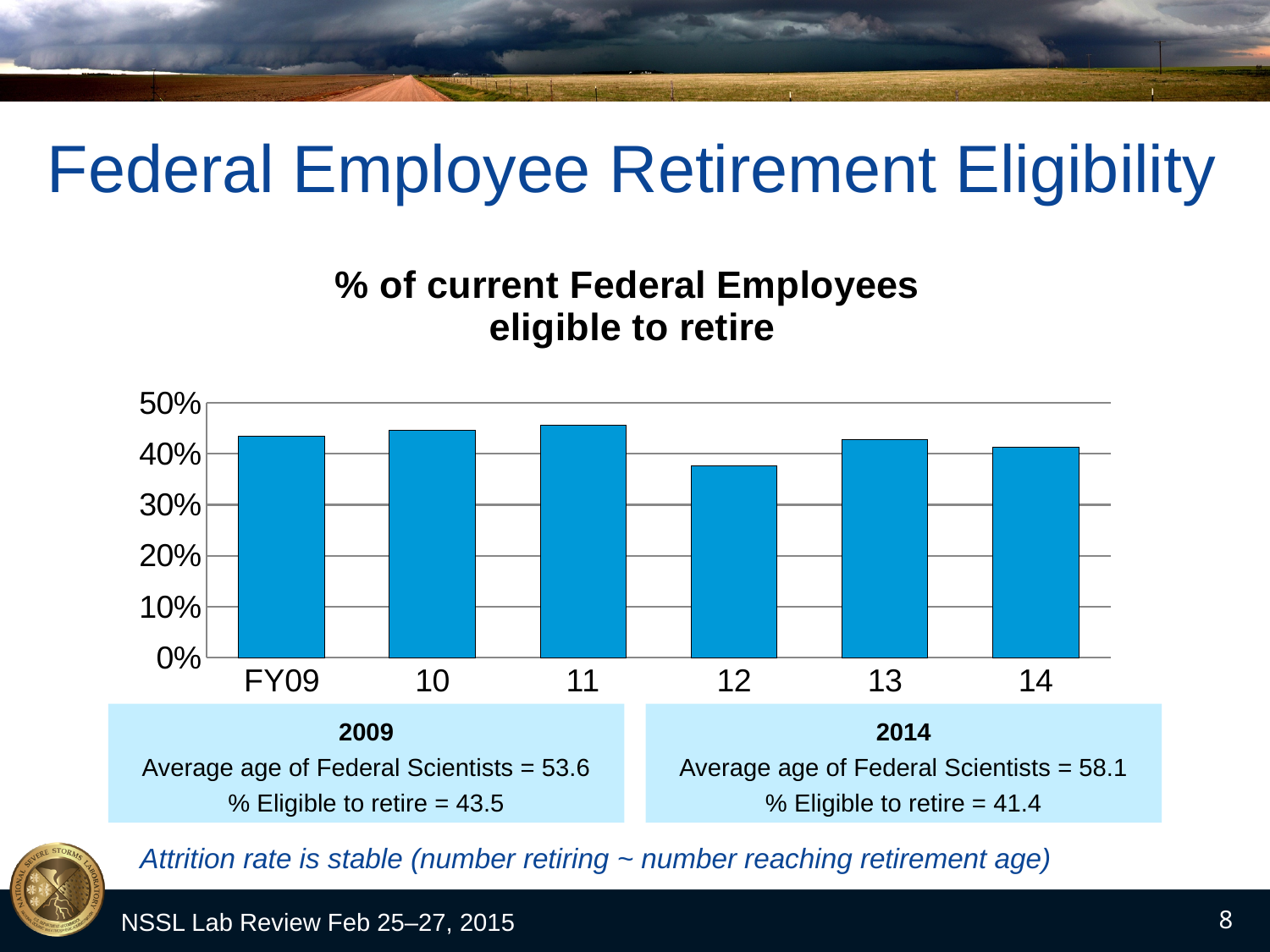
According to the slide, what percentage of Federal employees were eligible to retire in 2014? 41.4 Is the value for FY12 greater or less than 40%? less Which is larger, the value for FY11 or the value for FY12? FY11 Is the value for FY11 greater or less than 50%? less What is the title of the chart? % of current Federal Employees eligible to retire Which fiscal year has the lowest percentage of Federal employees eligible to retire? 12 Is the value for FY09 greater or less than 40%? greater What kind of chart is shown on the slide? bar chart How many fiscal years are plotted in the chart? 6 According to the slide, what percentage of Federal employees were eligible to retire in 2009? 43.5 Which fiscal year has the highest percentage of Federal employees eligible to retire? 11